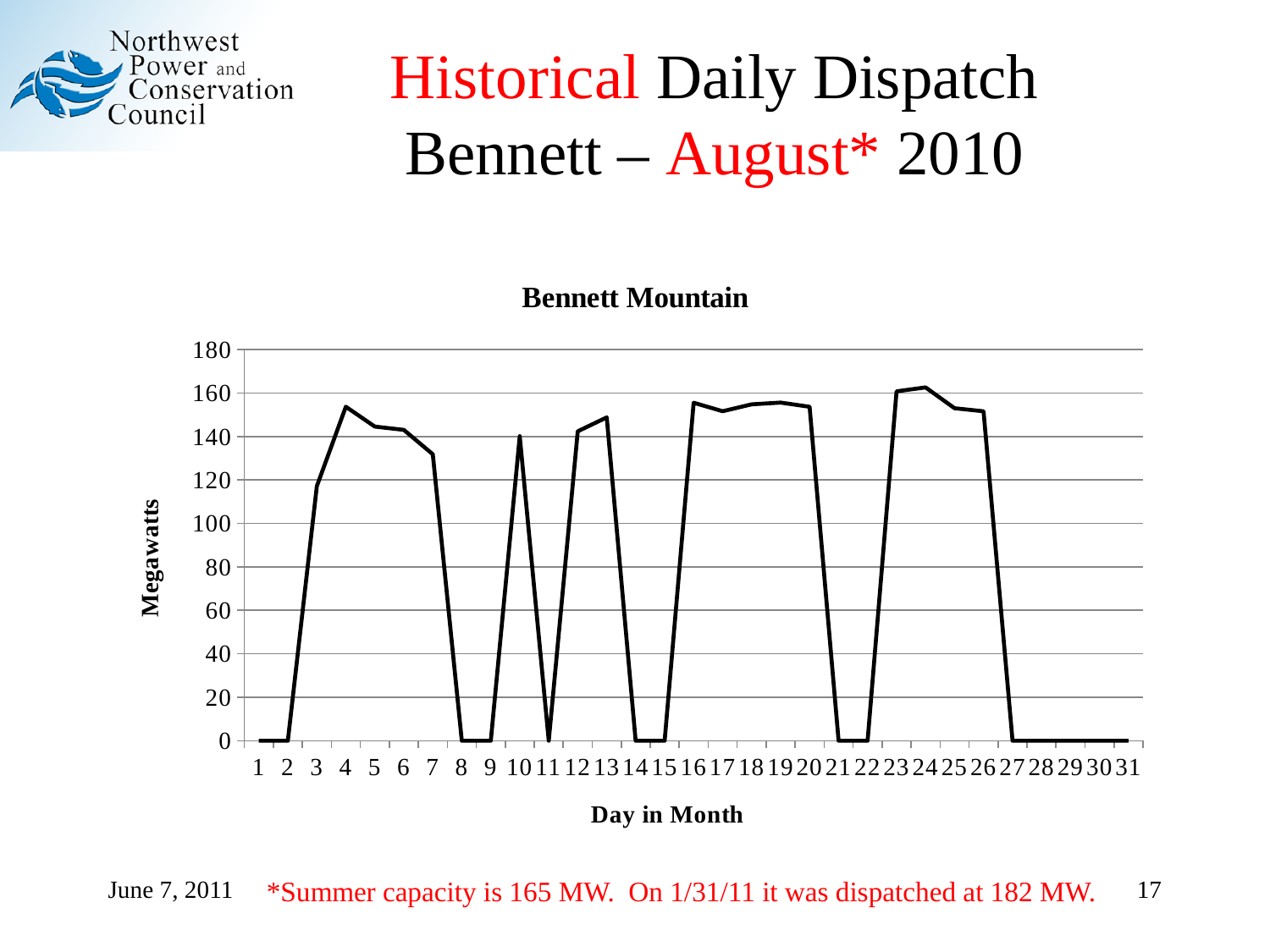
What kind of chart is shown on the slide? line chart What is the value for day 29? 0 Do the values rise or fall from day 4 to day 7? fall Which is larger, the value for day 4 or the value for day 7? day 4 How many days are plotted along the x axis? 31 Is the value for day 7 greater or less than 140? less What is the title of the chart? Bennett Mountain Is the value for day 4 greater or less than 140? greater What is the value for day 15? 0 Is the value for day 3 greater or less than 100? greater What is the label of the y axis? Megawatts What is the value for day 1? 0